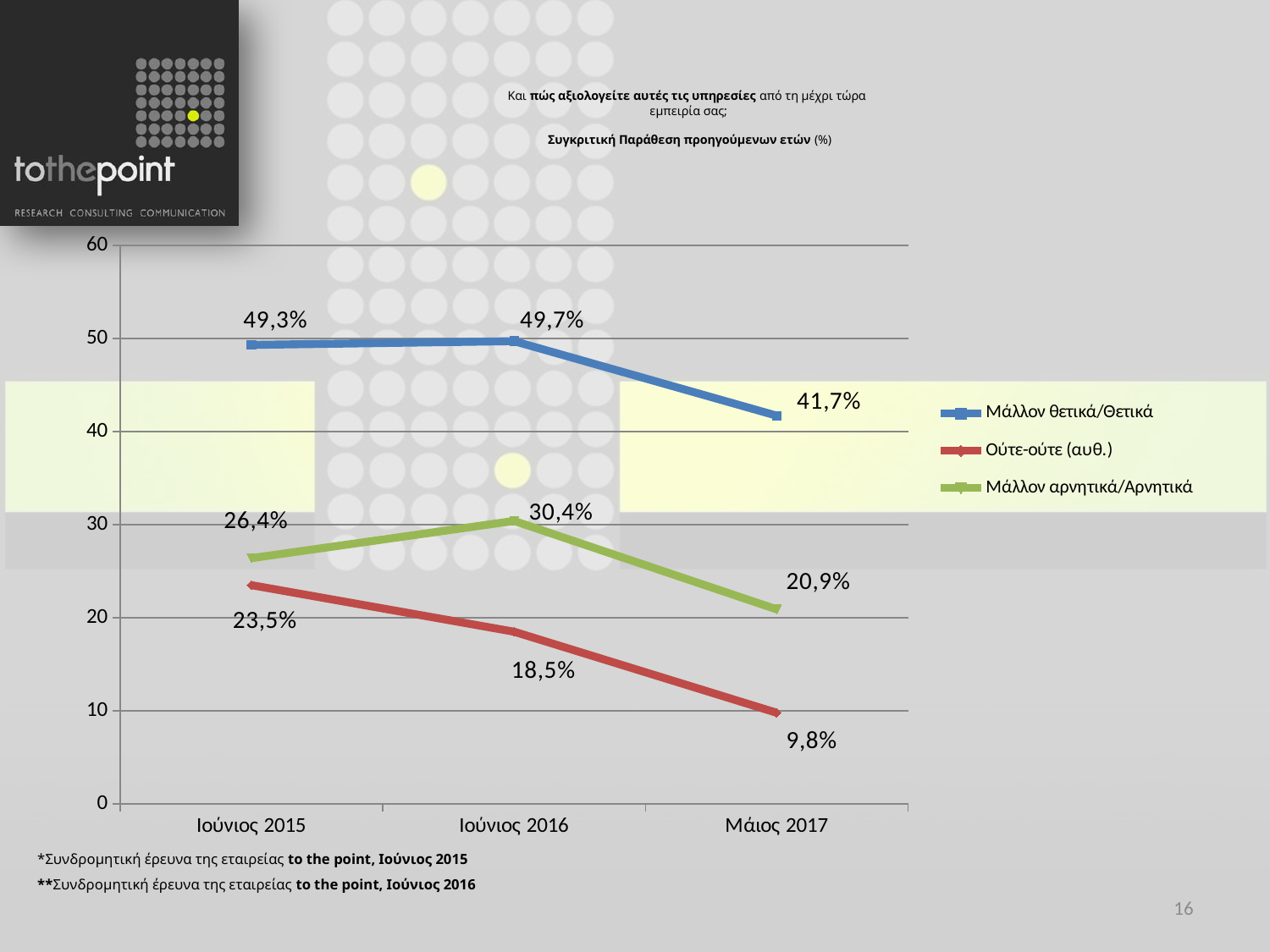
What colour is the line for Μάλλον θετικά/Θετικά? Blue How many time points are shown on the x axis? 3 What is the difference between the Μάλλον θετικά/Θετικά values in Ιούνιος 2016 and Μάιος 2017? 8 percentage points How many series does the legend list? 3 What is the value for Μάλλον αρνητικά/Αρνητικά in Ιούνιος 2015? 26,4% In which period does Μάλλον αρνητικά/Αρνητικά reach its highest value? Ιούνιος 2016 What is the value for Μάλλον θετικά/Θετικά in Μάιος 2017? 41,7% Does the Ούτε-ούτε (αυθ.) series rise or fall from Ιούνιος 2015 to Μάιος 2017? Fall Which is larger in Ιούνιος 2015: Μάλλον αρνητικά/Αρνητικά or Ούτε-ούτε (αυθ.)? Μάλλον αρνητικά/Αρνητικά In which period does Ούτε-ούτε (αυθ.) have its lowest value? Μάιος 2017 What is the value for Ούτε-ούτε (αυθ.) in Ιούνιος 2016? 18,5% What type of chart is shown on the slide? Line chart